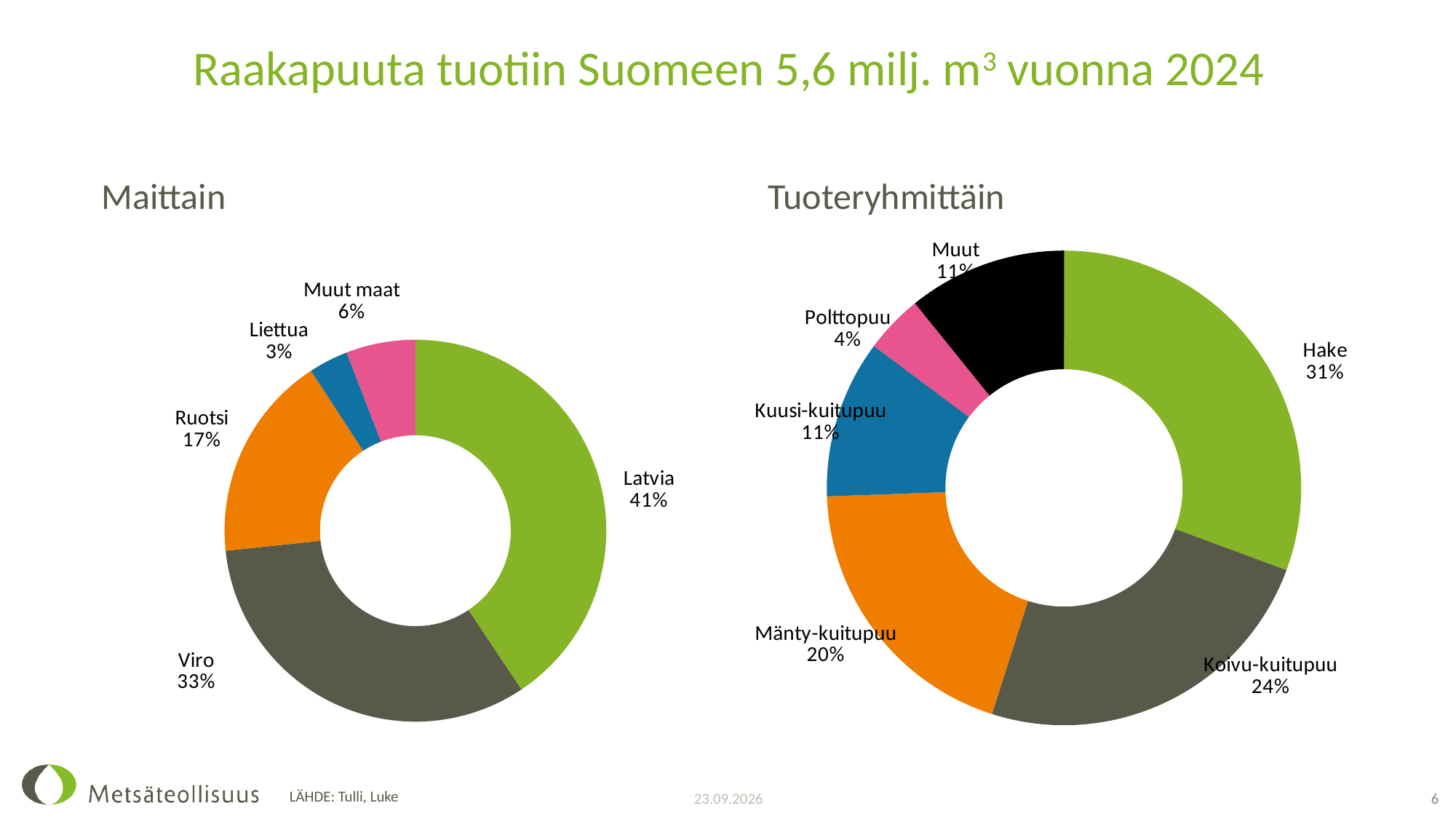
In the "Maittain" chart, what is the difference between the shares of Latvia and Viro? 8 percentage points In the "Maittain" chart, which country has the largest share? Latvia In the "Maittain" chart, what share does Ruotsi have? 17% In the "Tuoteryhmittäin" chart, which product group has the largest share? Hake In the "Maittain" chart, how many categories are shown? 5 In the "Tuoteryhmittäin" chart, what share does Koivu-kuitupuu have? 24% In the "Tuoteryhmittäin" chart, which is larger, Mänty-kuitupuu or Kuusi-kuitupuu? Mänty-kuitupuu In the "Tuoteryhmittäin" chart, how many categories are shown? 6 In the "Tuoteryhmittäin" chart, what share does Polttopuu have? 4% In the "Maittain" chart, which category has the smallest share? Liettua In the "Maittain" chart, what share does Latvia have? 41% What type of chart is the "Maittain" chart? Pie chart (doughnut)